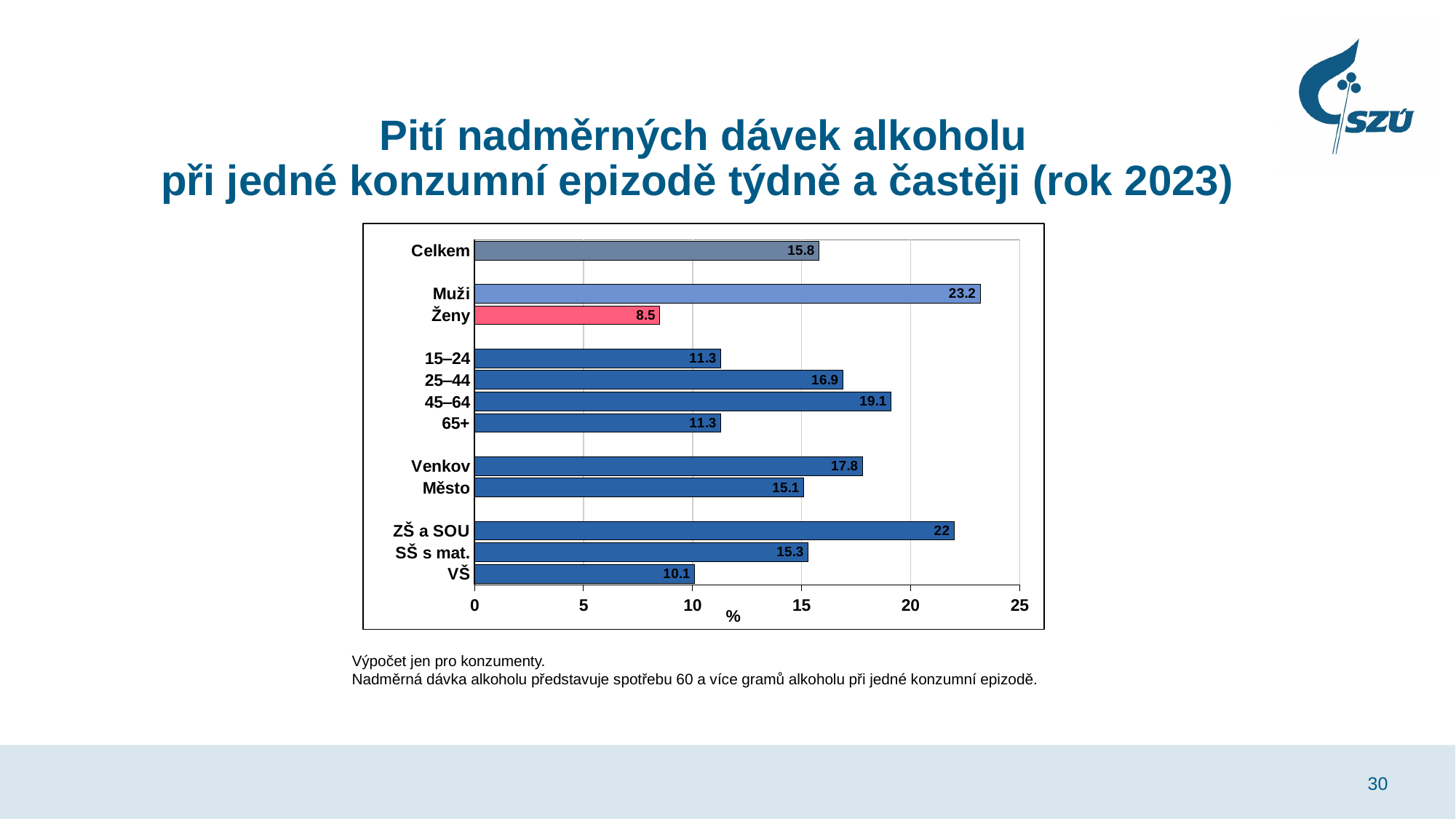
What is the value for Celkem? 15.8 What is the value for Ženy? 8.5 Which has a larger value, ZŠ a SOU or VŠ? ZŠ a SOU What is the difference between the values for Venkov and Město? 2.7 Which category has the highest value? Muži How many bars are plotted in the chart? 12 What is the value for the 45–64 age group? 19.1 What unit is shown on the horizontal axis? % What kind of chart is shown on the slide? Bar chart What is the value for Muži? 23.2 Which category has the lowest value? Ženy What is the difference between the values for Muži and Ženy? 14.7